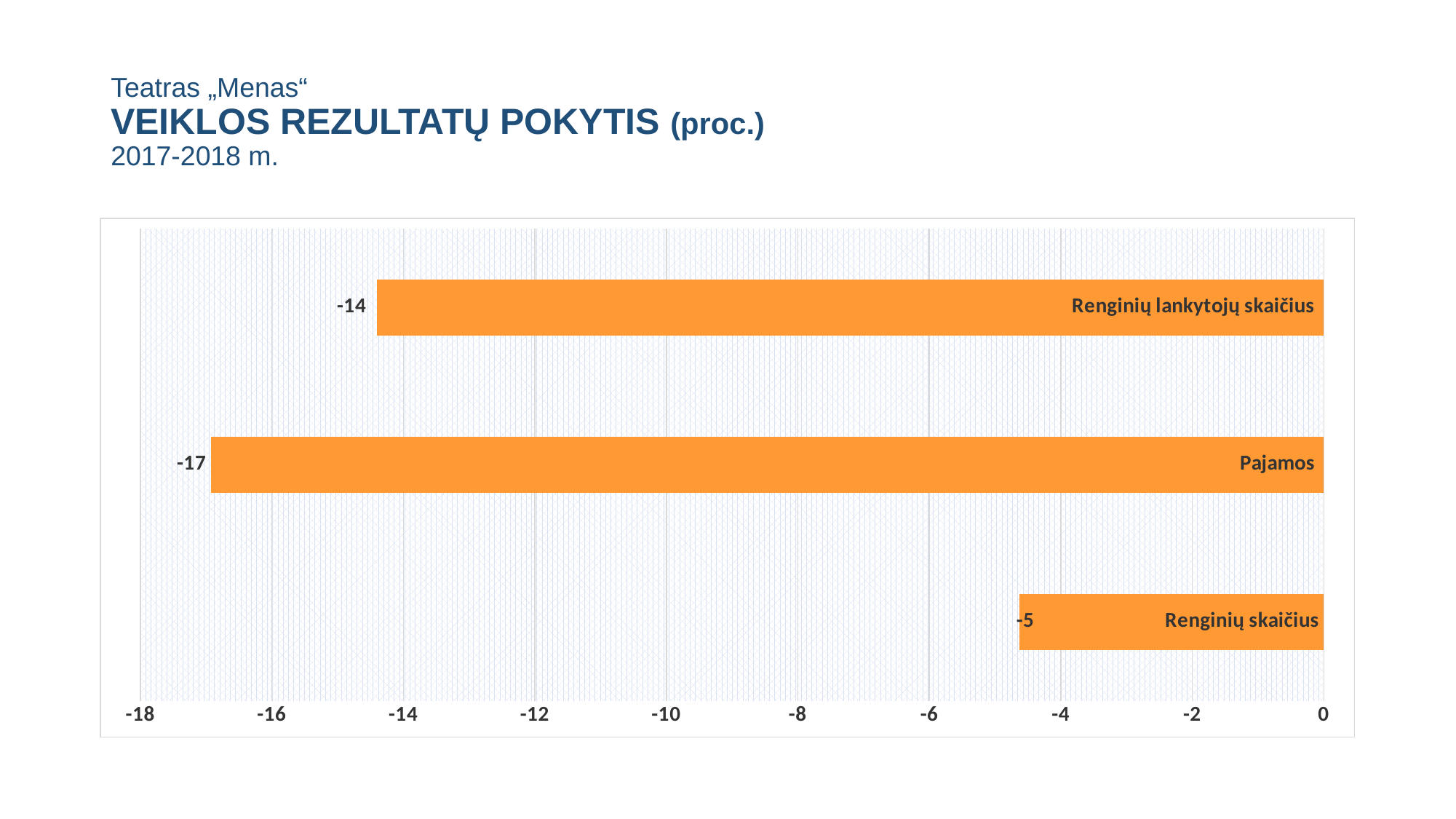
Is the value for Pajamos greater or less than -10? less What is the main title of the chart on the slide? VEIKLOS REZULTATŲ POKYTIS (proc.) What kind of chart is shown on the slide? bar chart What is the difference between the values for Renginių lankytojų skaičius and Renginių skaičius? 9 What is the value shown for Pajamos? -17 Which category has the highest (least negative) value? Renginių skaičius What is the difference between the values for Pajamos and Renginių lankytojų skaičius? 3 What is the value shown for Renginių skaičius? -5 How many categories are shown in the chart? 3 Which has a larger (less negative) value, Pajamos or Renginių skaičius? Renginių skaičius What is the value shown for Renginių lankytojų skaičius? -14 Which category has the lowest (most negative) value? Pajamos